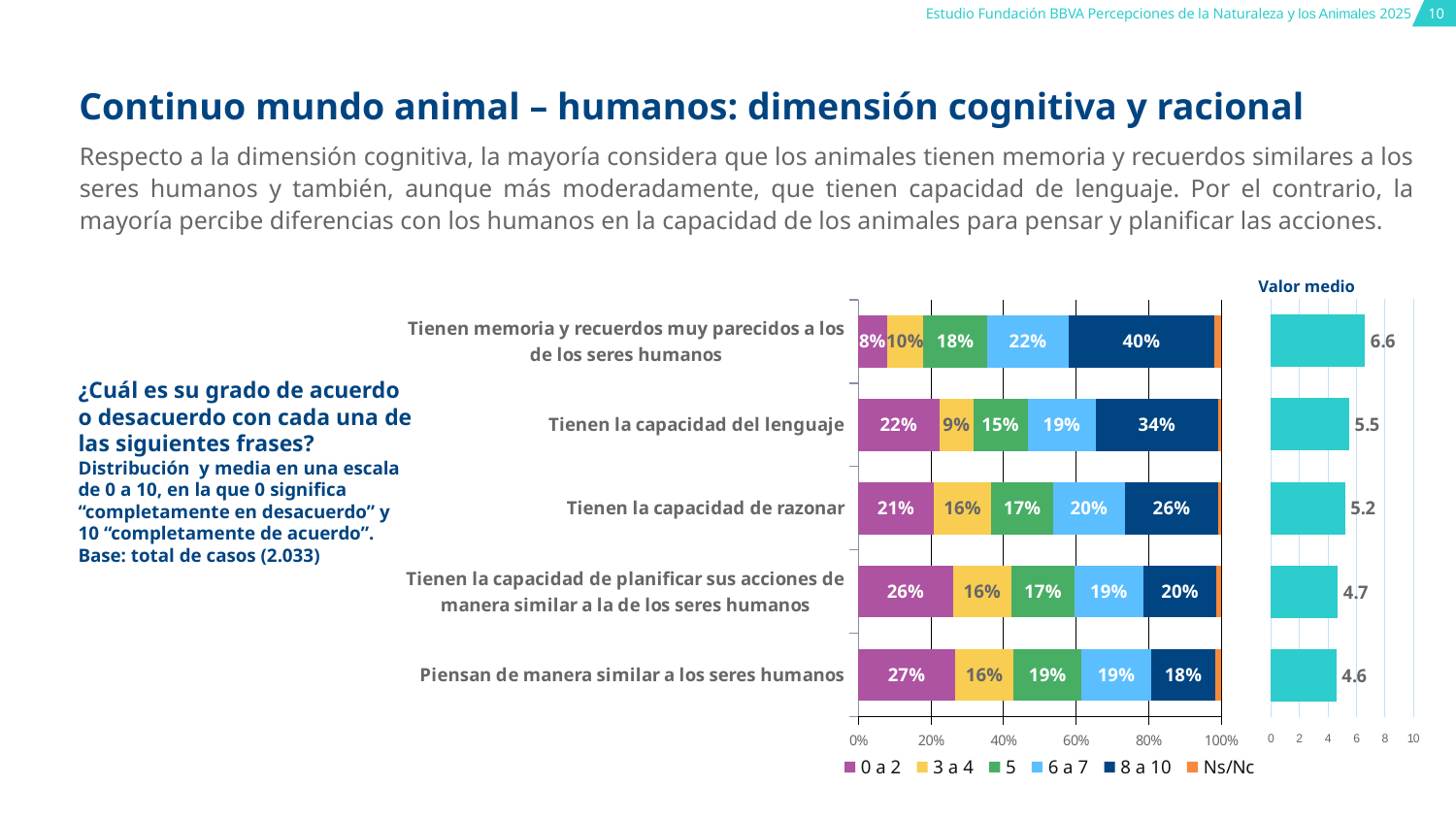
How many statements are shown in the stacked bar chart? 5 How many series does the legend of the stacked bar chart list? 6 In the Valor medio chart, do the mean values rise or fall going from the top statement to the bottom statement? fall In the Valor medio chart, which statement has the lowest mean value? Piensan de manera similar a los seres humanos In the Valor medio chart, which statement has the highest mean value? Tienen memoria y recuerdos muy parecidos a los de los seres humanos In the stacked bar chart, what is the difference between the 8 a 10 share for "Tienen memoria y recuerdos muy parecidos a los de los seres humanos" and for "Tienen la capacidad del lenguaje"? 6% In the Valor medio chart, what is the mean value for "Tienen la capacidad del lenguaje"? 5.5 In the stacked bar chart, what percentage answered 0 a 2 for "Tienen la capacidad de planificar sus acciones de manera similar a la de los seres humanos"? 26% In the stacked bar chart, which has a larger 0 a 2 share: "Piensan de manera similar a los seres humanos" or "Tienen la capacidad de razonar"? Piensan de manera similar a los seres humanos What kind of chart is the Valor medio chart? bar chart In the stacked bar chart, what percentage of respondents answered 8 a 10 for "Tienen memoria y recuerdos muy parecidos a los de los seres humanos"? 40% In the Valor medio chart, is the mean value for "Tienen la capacidad de razonar" greater or less than 4? greater